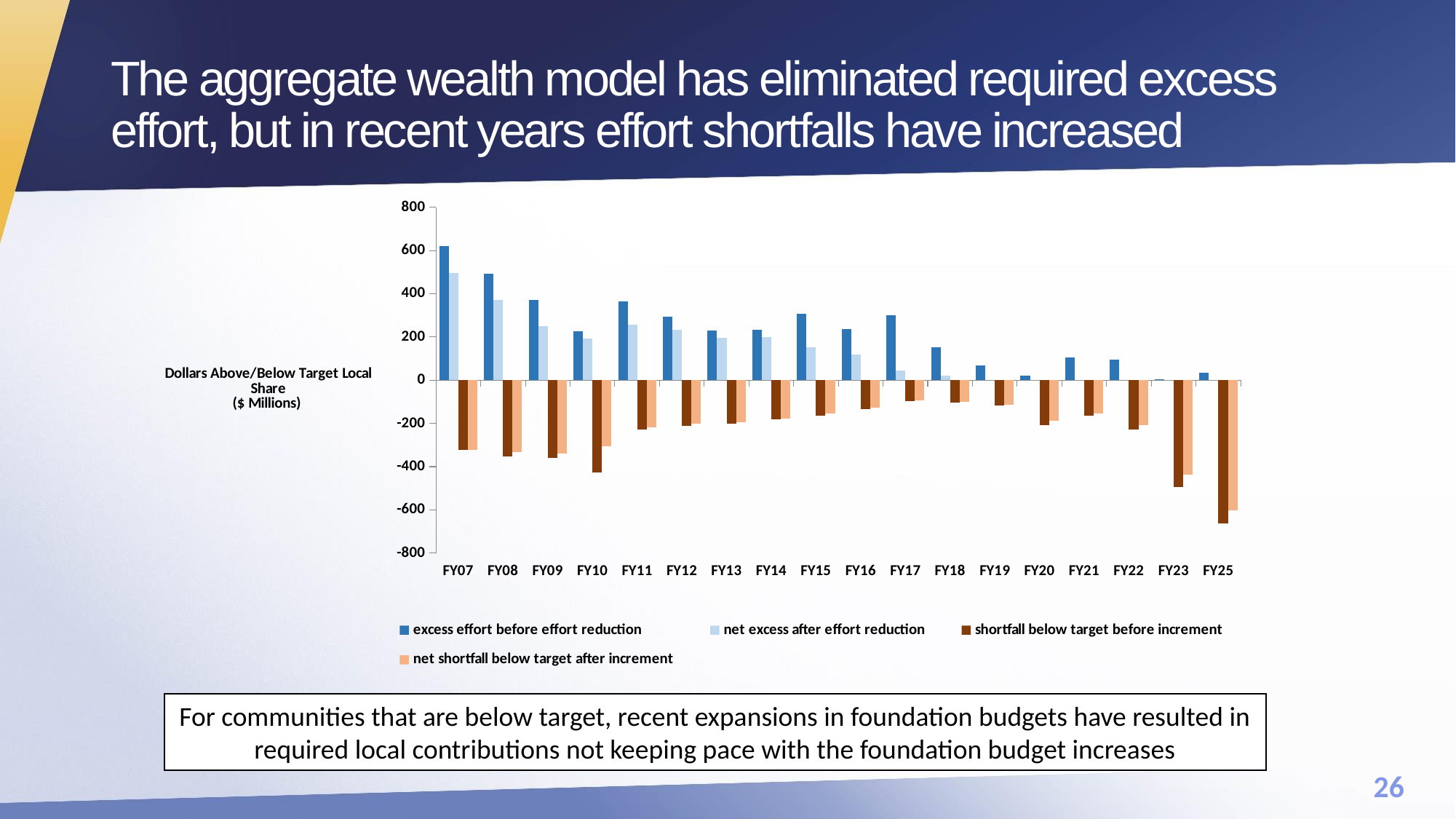
How many series does the legend list? 4 How many fiscal years are shown on the x axis? 18 Is the value for excess effort before effort reduction in FY07 greater or less than 400? greater What is the label on the vertical axis of the chart? Dollars Above/Below Target Local Share ($ Millions) Which fiscal year has the lowest (most negative) value for shortfall below target before increment? FY25 Is the value for shortfall below target before increment in FY23 greater or less than -400? less Which fiscal year has the highest value for excess effort before effort reduction? FY07 Is the value for shortfall below target before increment in FY25 greater or less than -600? less What kind of chart is shown on the slide? bar chart Which legend entry is shown in dark brown? shortfall below target before increment Which is larger, the excess effort before effort reduction in FY07 or in FY08? FY07 Does the excess effort before effort reduction generally rise or fall from FY07 to FY25? fall